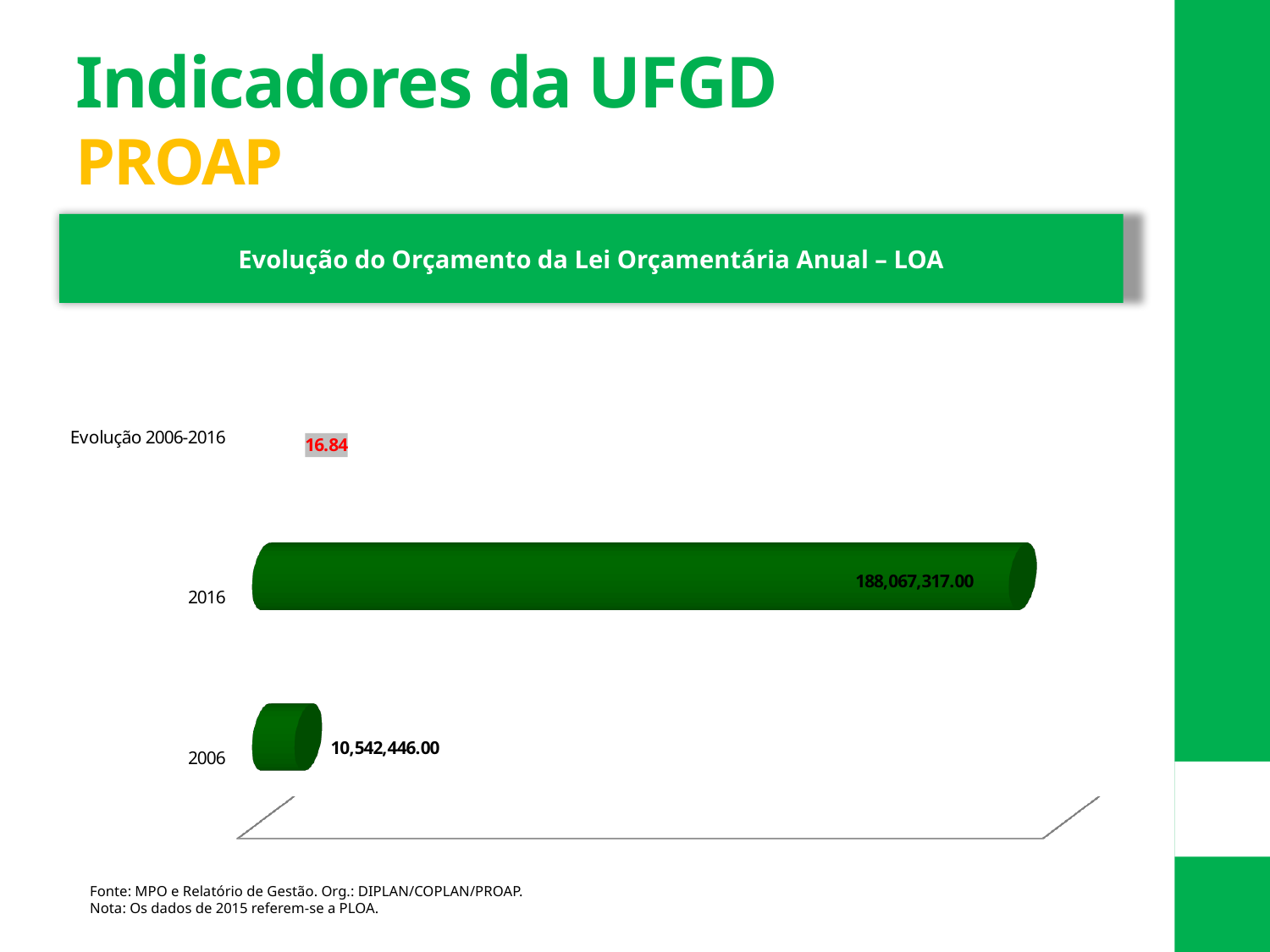
What is the value shown for 2016? 188,067,317.00 Which year has the lowest value in the chart? 2006 What value is shown for "Evolução 2006-2016"? 16.84 What is the title of the chart on the slide? Evolução do Orçamento da Lei Orçamentária Anual – LOA What is the difference between the 2016 value and the 2006 value? 177,524,871.00 How many years are plotted as bars in the chart? 2 Does the budget value rise or fall from 2006 to 2016? Rise What kind of chart is shown on the slide? Bar chart What colour are the bars in the chart? Green What is the value shown for 2006? 10,542,446.00 Which year has the larger budget value, 2006 or 2016? 2016 Which year has the highest value in the chart? 2016